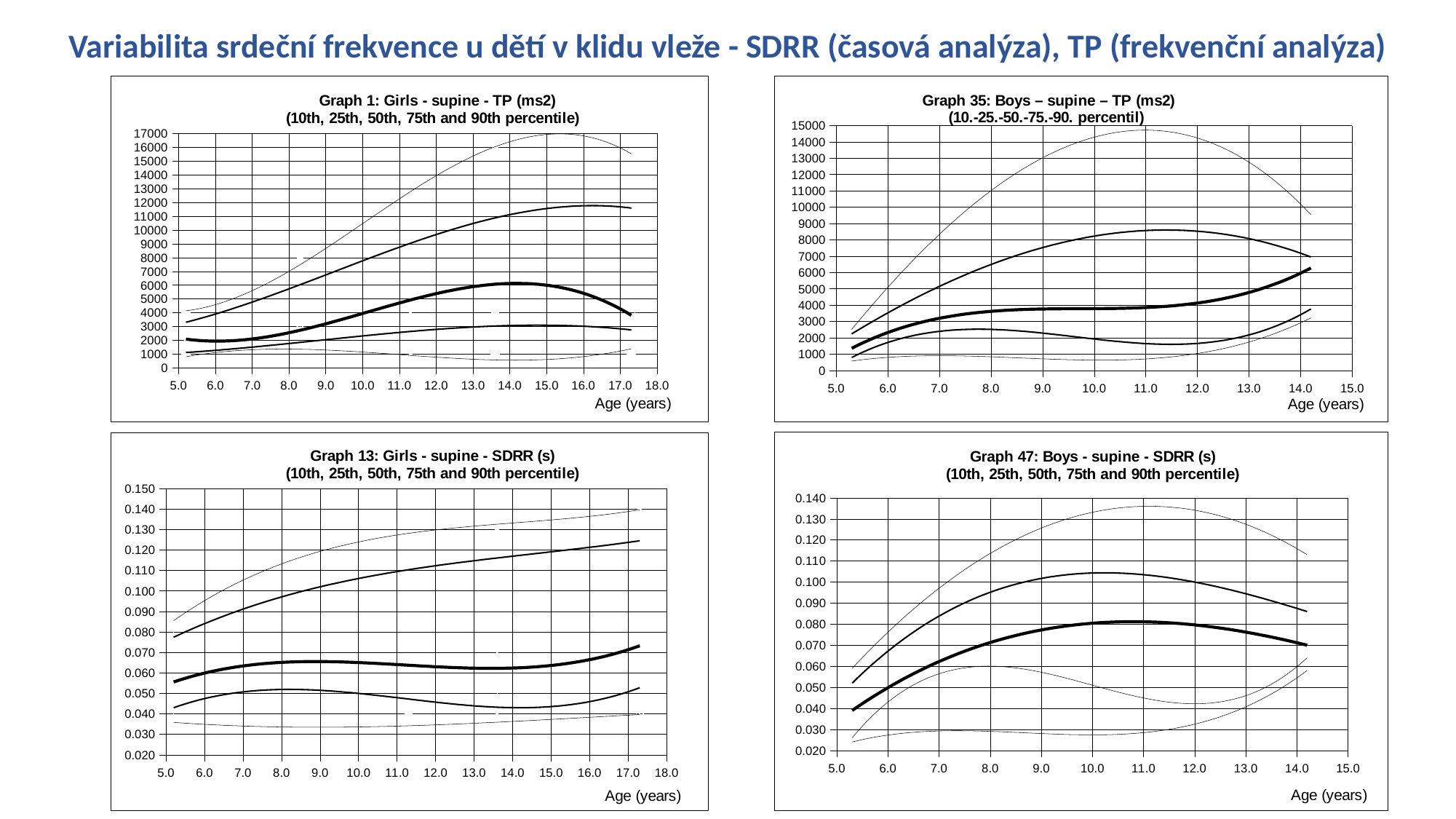
In Graph 1: Girls - supine - TP (ms2), is the value of the thick 50th percentile curve at age 14.0 greater or less than 5000? greater In Graph 1: Girls - supine - TP (ms2), is the peak value reached by the topmost (90th percentile) curve greater or less than 15000? greater In Graph 47: Boys - supine - SDRR (s), is the value of the thick 50th percentile curve at age 11.0 greater or less than 0.070? greater Which chart's topmost curve reaches a higher peak value, Graph 1 (Girls TP) or Graph 35 (Boys TP)? Graph 1 What kind of chart is Graph 1: Girls - supine - TP (ms2)? line chart In Graph 13: Girls - supine - SDRR (s), does the topmost curve rise or fall from age 5.0 to age 17.0? rise How many percentile curves are plotted in Graph 13: Girls - supine - SDRR (s)? 5 What is the title of the bottom-left chart? Graph 13: Girls - supine - SDRR (s) What is the x-axis label on Graph 35: Boys – supine – TP (ms2)? Age (years) How many charts are shown on the slide? 4